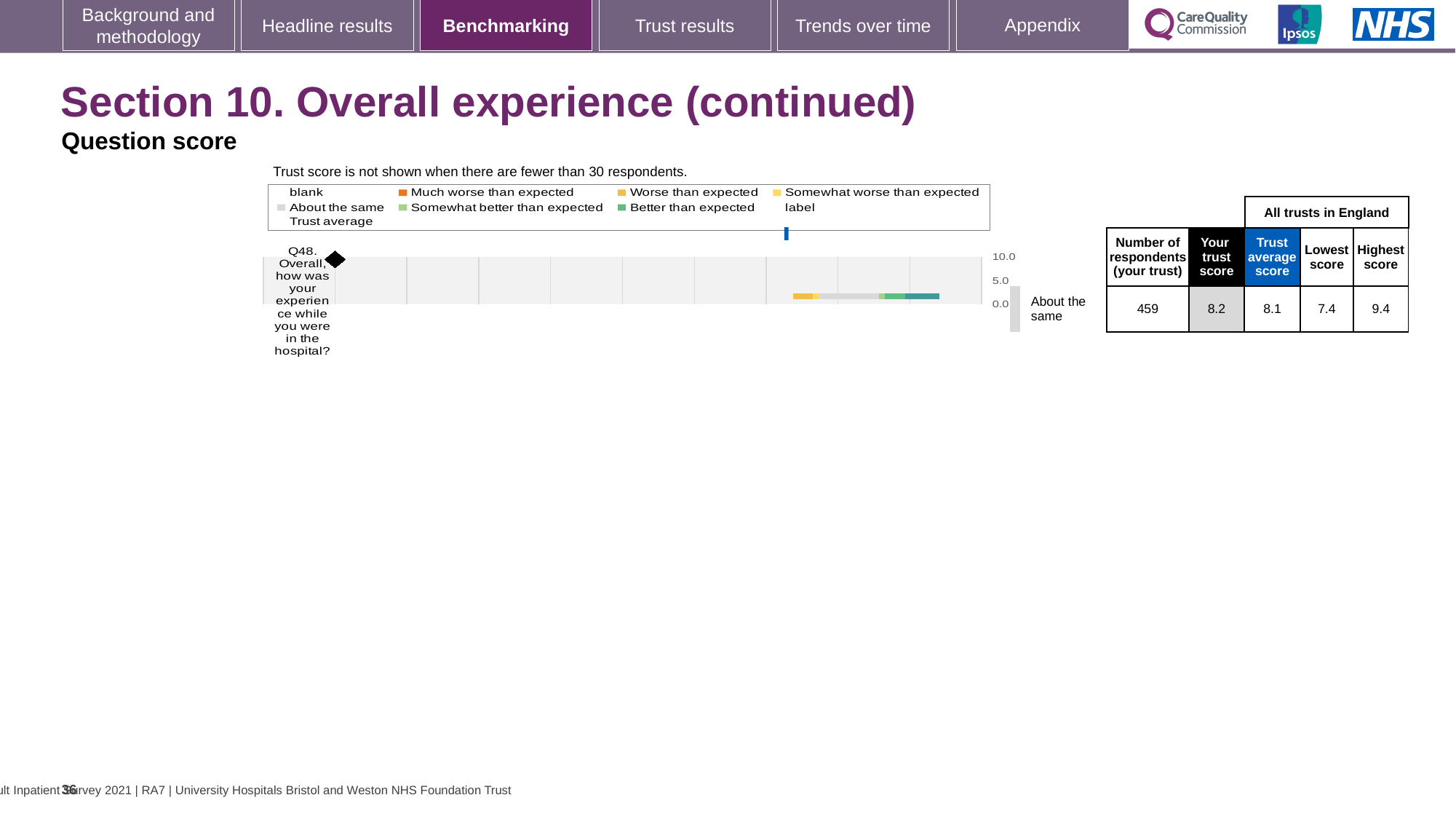
Which question is plotted on the chart? Q48. Overall, how was your experience while you were in the hospital? What kind of chart is shown on the slide? bar chart What is the highest score for Q48 across all trusts in England? 9.4 What is the number of respondents for Q48 at your trust? 459 What is the benchmark category shown next to the bar for Q48? About the same What is your trust score for Q48? 8.2 What is the difference between your trust score and the trust average score for Q48? 0.1 What is the difference between the highest and lowest scores for Q48 across all trusts in England? 2.0 How many questions (categories) are plotted on the chart? 1 What is the trust average score for Q48 across all trusts in England? 8.1 Which is larger for Q48: your trust score or the trust average score? your trust score What is the lowest score for Q48 across all trusts in England? 7.4